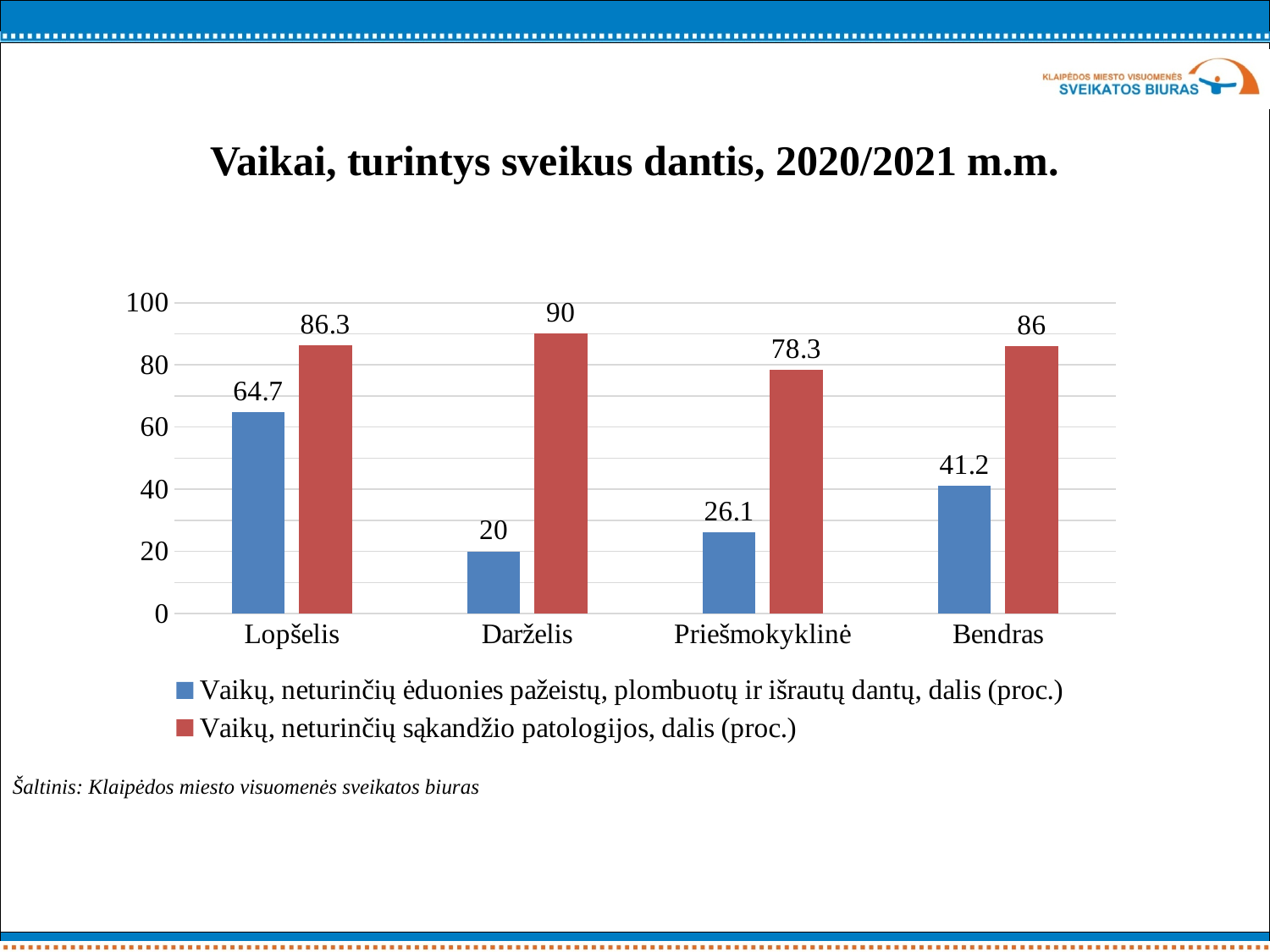
What is the value for Lopšelis in the series 'Vaikų, neturinčių ėduonies pažeistų, plombuotų ir išrautų dantų, dalis (proc.)'? 64.7 How many categories are shown on the x axis? 4 What is the difference between the two series values for Bendras? 44.8 Is the value for Priešmokyklinė in the series 'Vaikų, neturinčių sąkandžio patologijos, dalis (proc.)' greater or less than 60? greater What kind of chart is shown on the slide? bar chart Which category has the lowest value in the series 'Vaikų, neturinčių ėduonies pažeistų, plombuotų ir išrautų dantų, dalis (proc.)'? Darželis Which is larger for Lopšelis: the value for 'Vaikų, neturinčių ėduonies pažeistų, plombuotų ir išrautų dantų, dalis (proc.)' or the value for 'Vaikų, neturinčių sąkandžio patologijos, dalis (proc.)'? Vaikų, neturinčių sąkandžio patologijos, dalis (proc.) What is the value for Priešmokyklinė in the series 'Vaikų, neturinčių ėduonies pažeistų, plombuotų ir išrautų dantų, dalis (proc.)'? 26.1 How many series does the legend list? 2 What is the value for Darželis in the series 'Vaikų, neturinčių sąkandžio patologijos, dalis (proc.)'? 90 Which category has the highest value in the series 'Vaikų, neturinčių sąkandžio patologijos, dalis (proc.)'? Darželis What is the title of the chart? Vaikai, turintys sveikus dantis, 2020/2021 m.m.